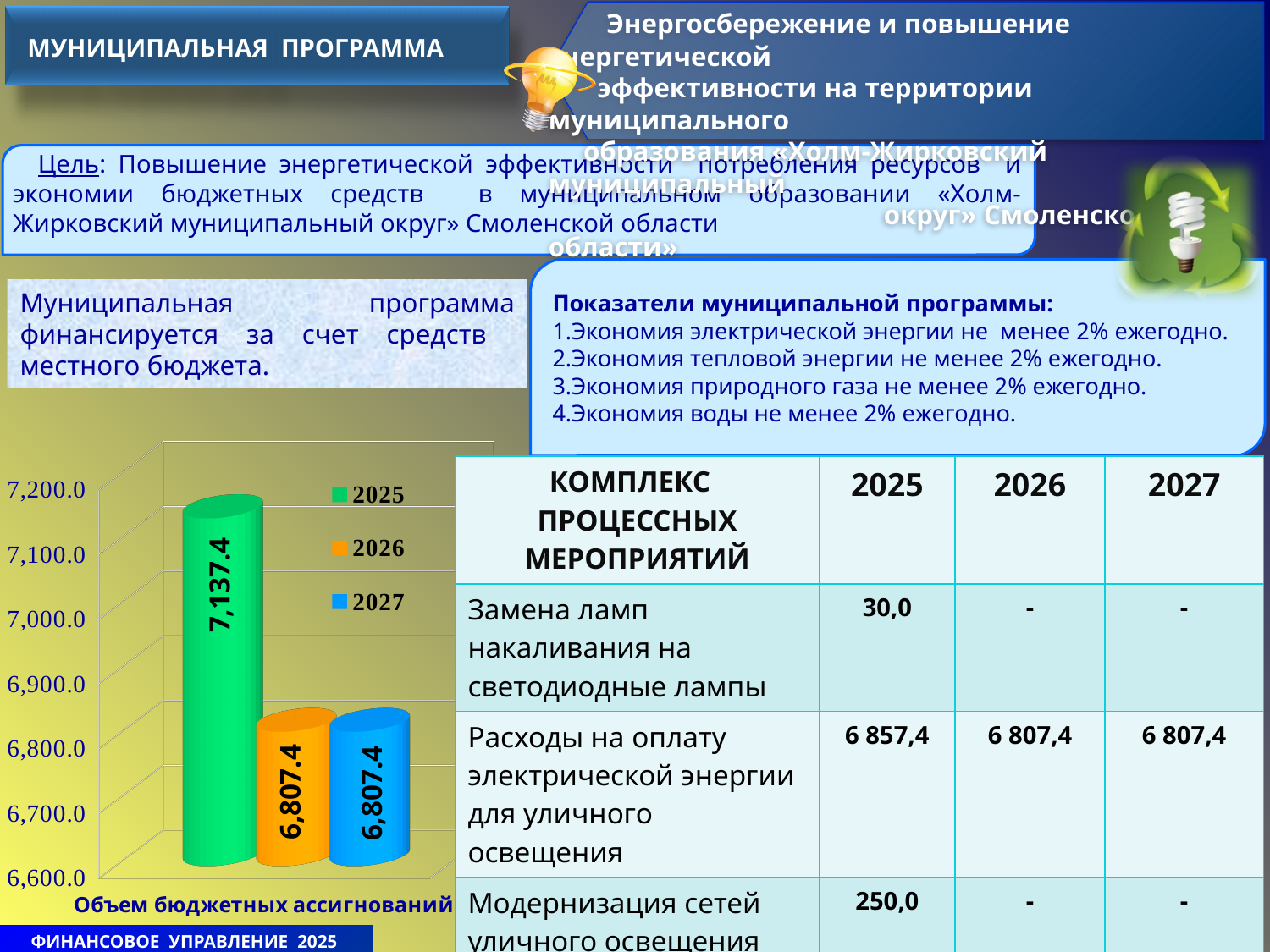
What is the value of the 2025 bar in the chart? 7,137.4 Which year has the highest value in the chart? 2025 Which is larger in the chart, the value for 2025 or the value for 2027? 2025 How many entries does the chart legend list? 3 What colour is the 2025 bar in the chart? green How many bars are plotted in the chart? 3 What is the value of the 2027 bar in the chart? 6,807.4 Is the value for 2026 in the chart greater or less than 6,900.0? less Is the value for 2025 in the chart greater or less than 7,100.0? greater What kind of chart is shown on the slide? bar chart What is the value of the 2026 bar in the chart? 6,807.4 What is the difference between the 2025 and 2026 values in the chart? 330.0